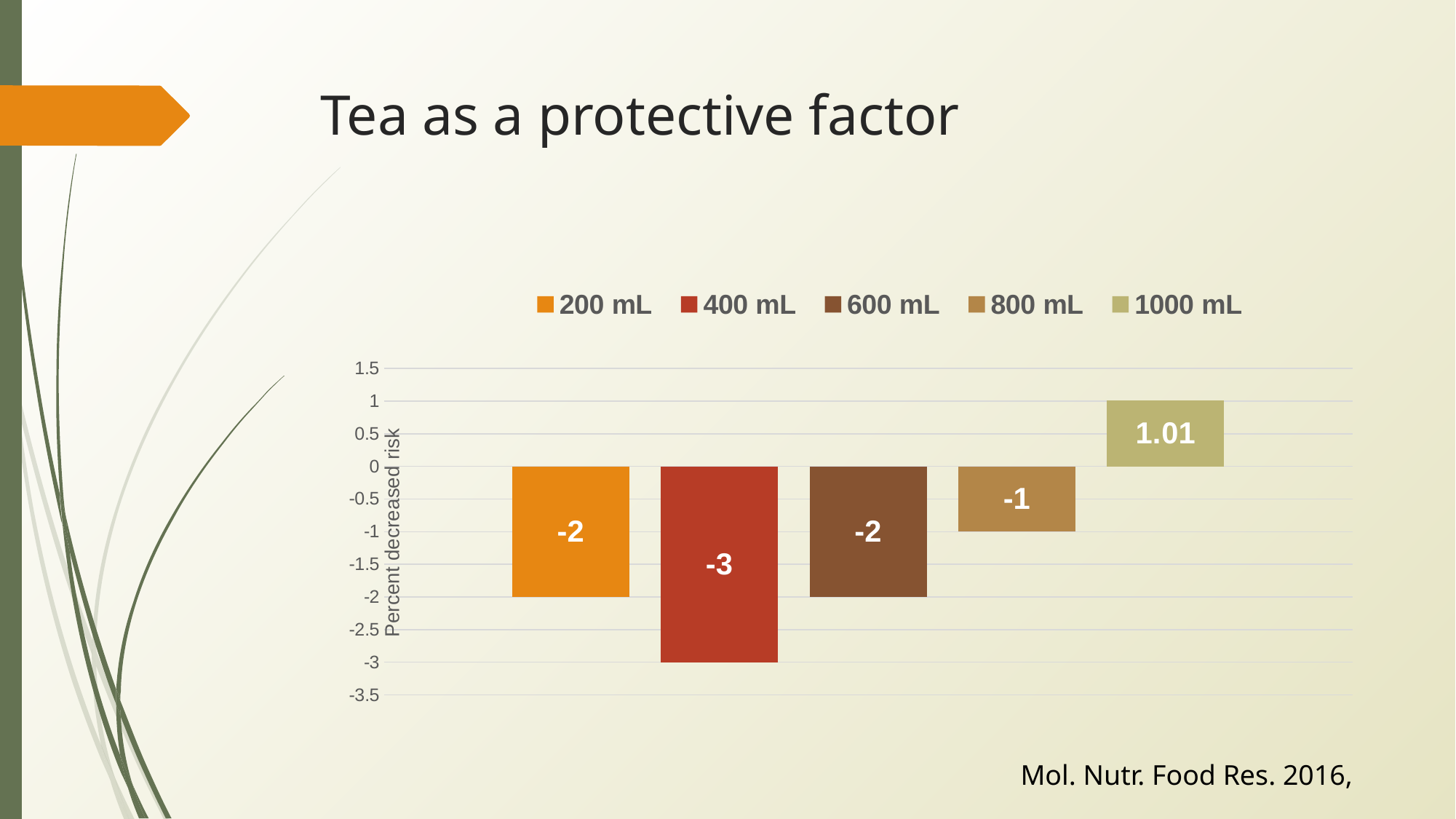
Which is larger, the value for 800 mL or the value for 600 mL? 800 mL What is the difference between the values for 1000 mL and 400 mL? 4.01 What is the value for 1000 mL? 1.01 What colour is the bar for 400 mL? Red What is the value for 200 mL? -2 How many series does the legend list? 5 What is the value for 400 mL? -3 What is the label of the vertical axis? Percent decreased risk What is the value for 800 mL? -1 What kind of chart is shown on the slide? Bar chart Which series has the highest value? 1000 mL Which series has the lowest value? 400 mL